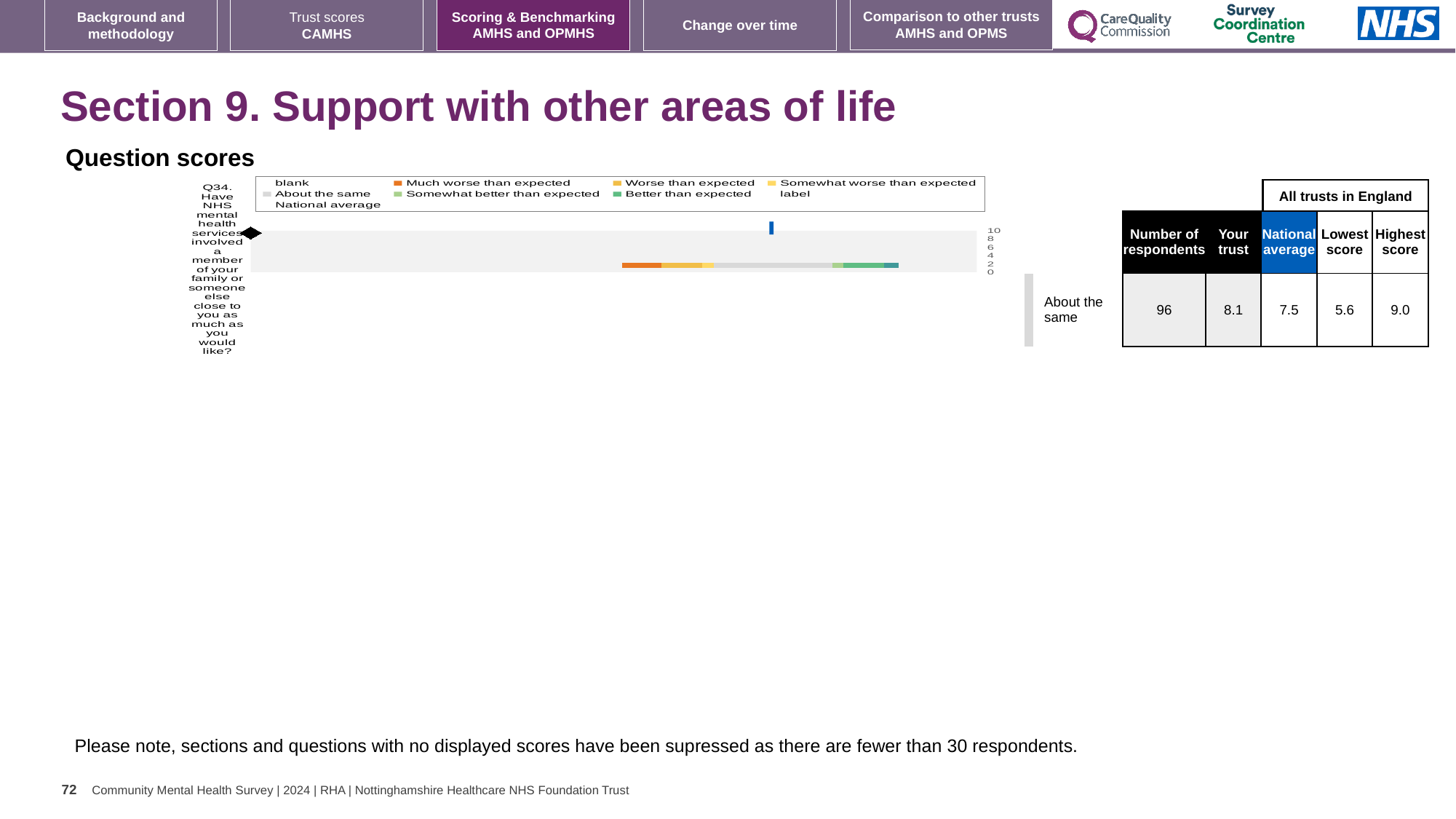
What is the highest value shown on the score axis of the Question scores chart? 10 Which question number is plotted in the Question scores chart? Q34 In the table beside the chart, how many respondents answered Q34? 96 In the table beside the chart, what is the Lowest score among all trusts in England for Q34? 5.6 How many survey questions are plotted in the Question scores chart? 1 What benchmark category is given for Q34 next to the chart? About the same For Q34, what is the difference between the 'Your trust' score and the National average? 0.6 What kind of chart is shown under 'Question scores'? bar chart For Q34, which is larger: the 'Your trust' score or the National average? Your trust In the table beside the chart, what is the National average score for Q34? 7.5 In the table beside the chart, what is the Highest score among all trusts in England for Q34? 9.0 In the table beside the chart, what is the 'Your trust' score for Q34? 8.1